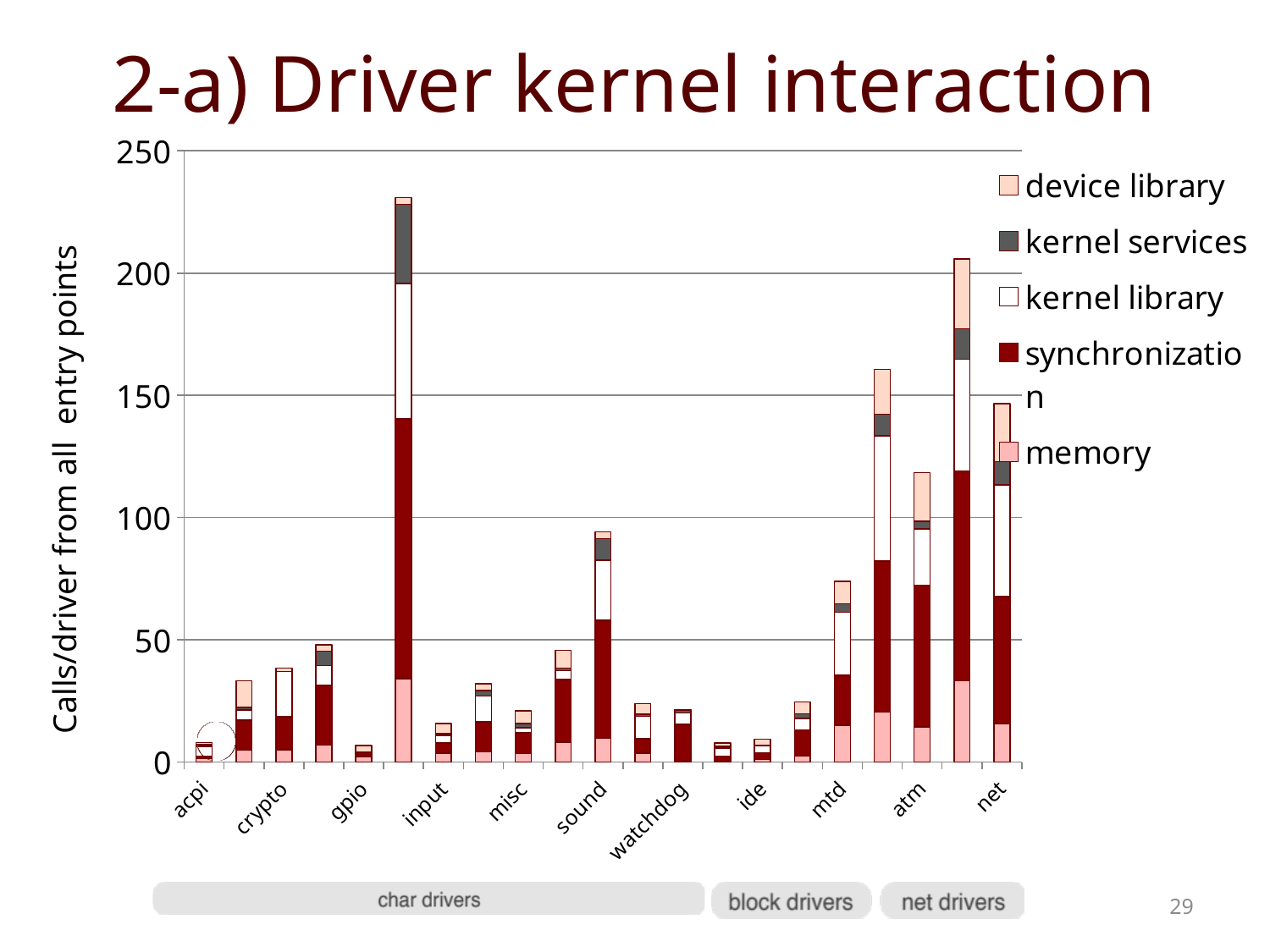
Which has the larger total, net or atm? net Is the value for net greater or less than 100? greater What kind of chart is shown on the slide? stacked bar chart Is the value for sound greater or less than 50? greater How many bars are plotted in the chart? 21 Is the tallest bar in the chart greater or less than 200? greater How many series does the legend list? 5 What is the label of the vertical axis? Calls/driver from all entry points Which series is shown in the darkest red colour in the legend? synchronization Which has the larger total, sound or mtd? sound